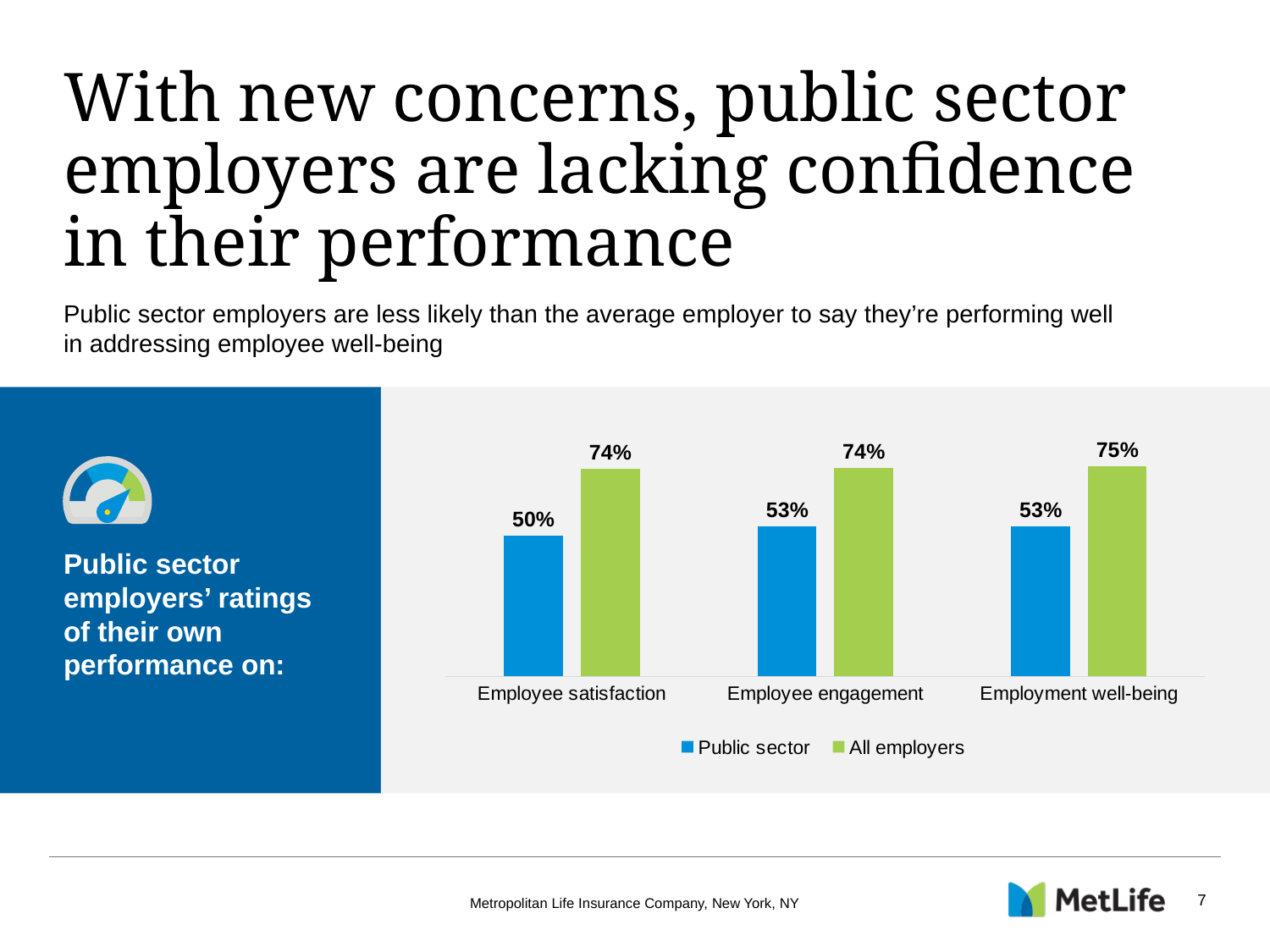
What is the All employers value for Employment well-being? 75% How many series does the legend list? 2 What is the Public sector value for Employee satisfaction? 50% Which category has the lowest Public sector value? Employee satisfaction Which category has the highest All employers value? Employment well-being Which is larger for Employee engagement: the Public sector value or the All employers value? All employers What is the All employers value for Employee satisfaction? 74% How many categories are shown on the x axis? 3 What kind of chart is shown on the slide? Bar chart What is the difference between the All employers and Public sector values for Employment well-being? 22% What is the Public sector value for Employee engagement? 53% What is the difference between the All employers and Public sector values for Employee satisfaction? 24%